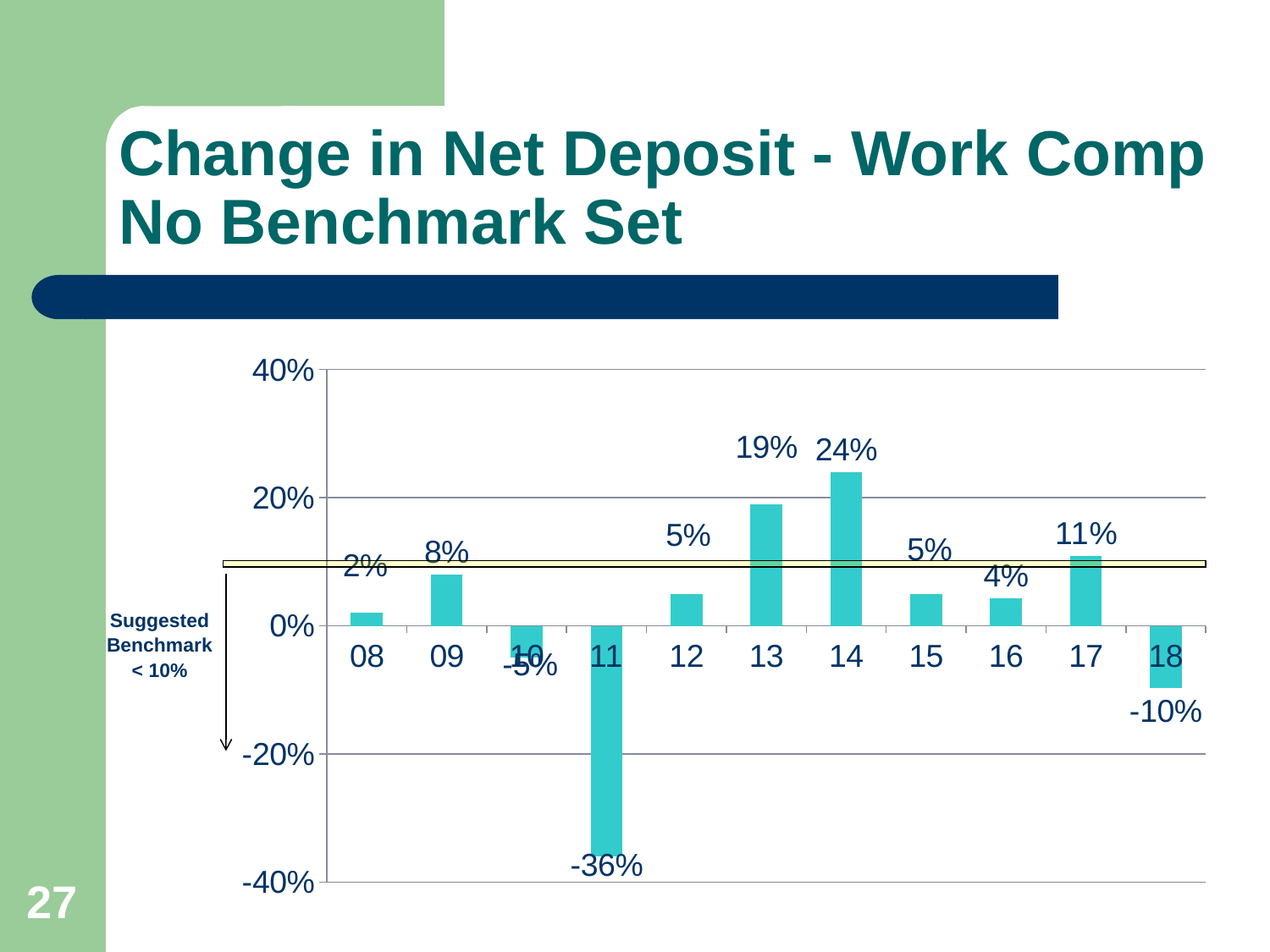
What suggested benchmark is marked by the horizontal line on the chart? < 10% Which year has the lowest value? 11 How many years are shown on the x axis? 11 What is the value for 17? 11% What is the value for 18? -10% Is the value for 13 greater or less than 20%? less What is the difference between the values for 14 and 13? 5% What is the value for 11? -36% What kind of chart is shown on the slide? bar chart What is the value for 14? 24% Which year has the highest value? 14 Which is larger, the value for 09 or the value for 16? 09